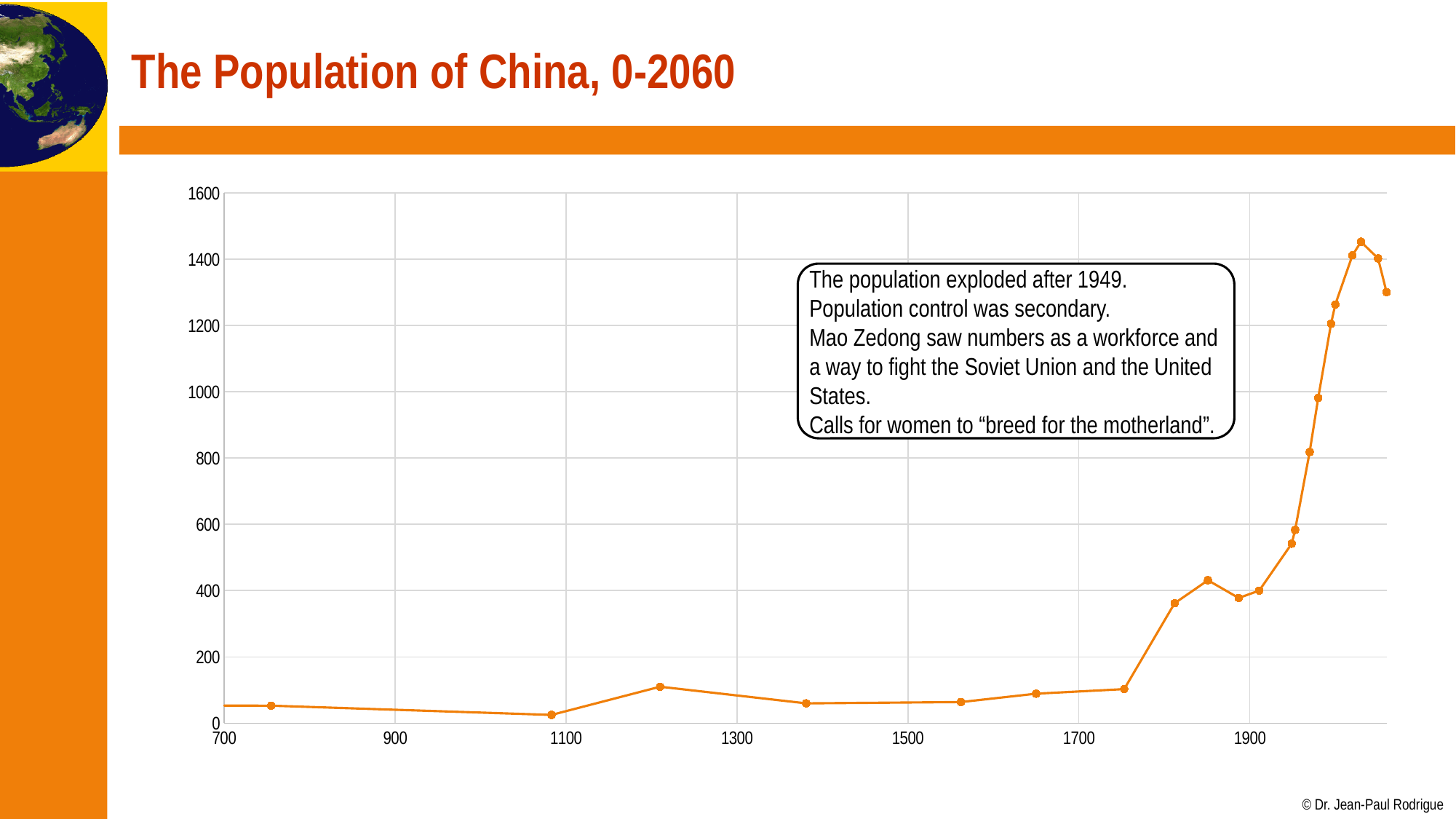
Is the value plotted at the year 1100 greater or less than 200? less Is the highest point on the line greater or less than 1400? greater What is the title of the slide containing the chart? The Population of China, 0-2060 Does the highest point on the line occur before or after the year 1900? after Overall, do the values rise or fall from the left of the x axis to the right? rise What kind of chart is shown on the slide? line chart Is the value plotted at the year 700 greater or less than 200? less Which is larger, the value plotted at the year 1900 or the value plotted at the year 1700? 1900 According to the callout on the chart, after which year did the population explode? 1949